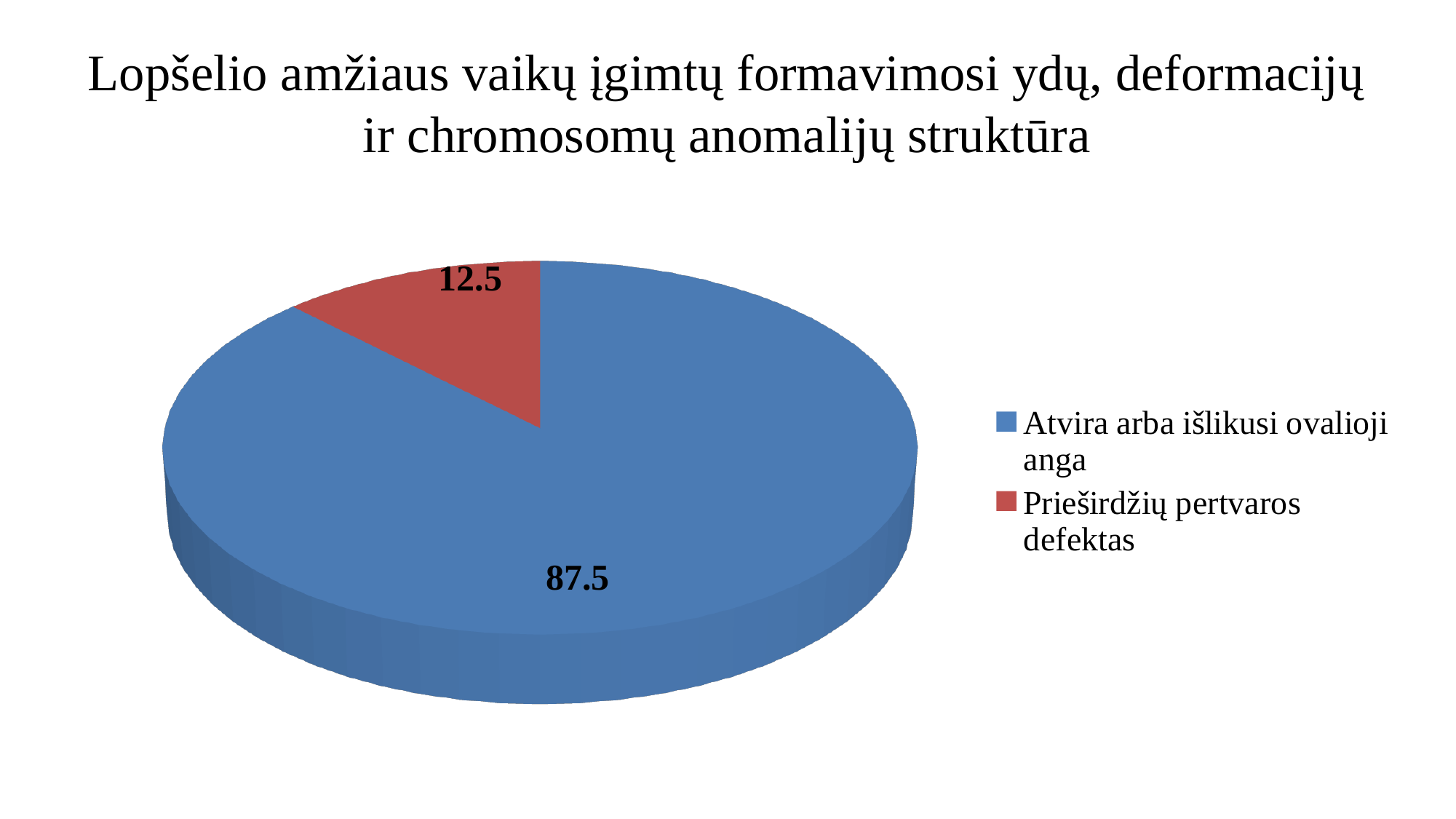
What kind of chart is shown on the slide? pie chart How many entries does the legend list? 2 Which category has the largest slice of the pie? Atvira arba išlikusi ovalioji anga What colour is the slice for Prieširdžių pertvaros defektas? red How many categories does the pie chart have? 2 Which category has the smallest slice of the pie? Prieširdžių pertvaros defektas What is the title of the slide? Lopšelio amžiaus vaikų įgimtų formavimosi ydų, deformacijų ir chromosomų anomalijų struktūra Which is larger, the value for Atvira arba išlikusi ovalioji anga or the value for Prieširdžių pertvaros defektas? Atvira arba išlikusi ovalioji anga What is the difference between the values for Atvira arba išlikusi ovalioji anga and Prieširdžių pertvaros defektas? 75 What is the value for Atvira arba išlikusi ovalioji anga? 87.5 What is the value for Prieširdžių pertvaros defektas? 12.5 What is the total of the two values shown on the pie chart? 100